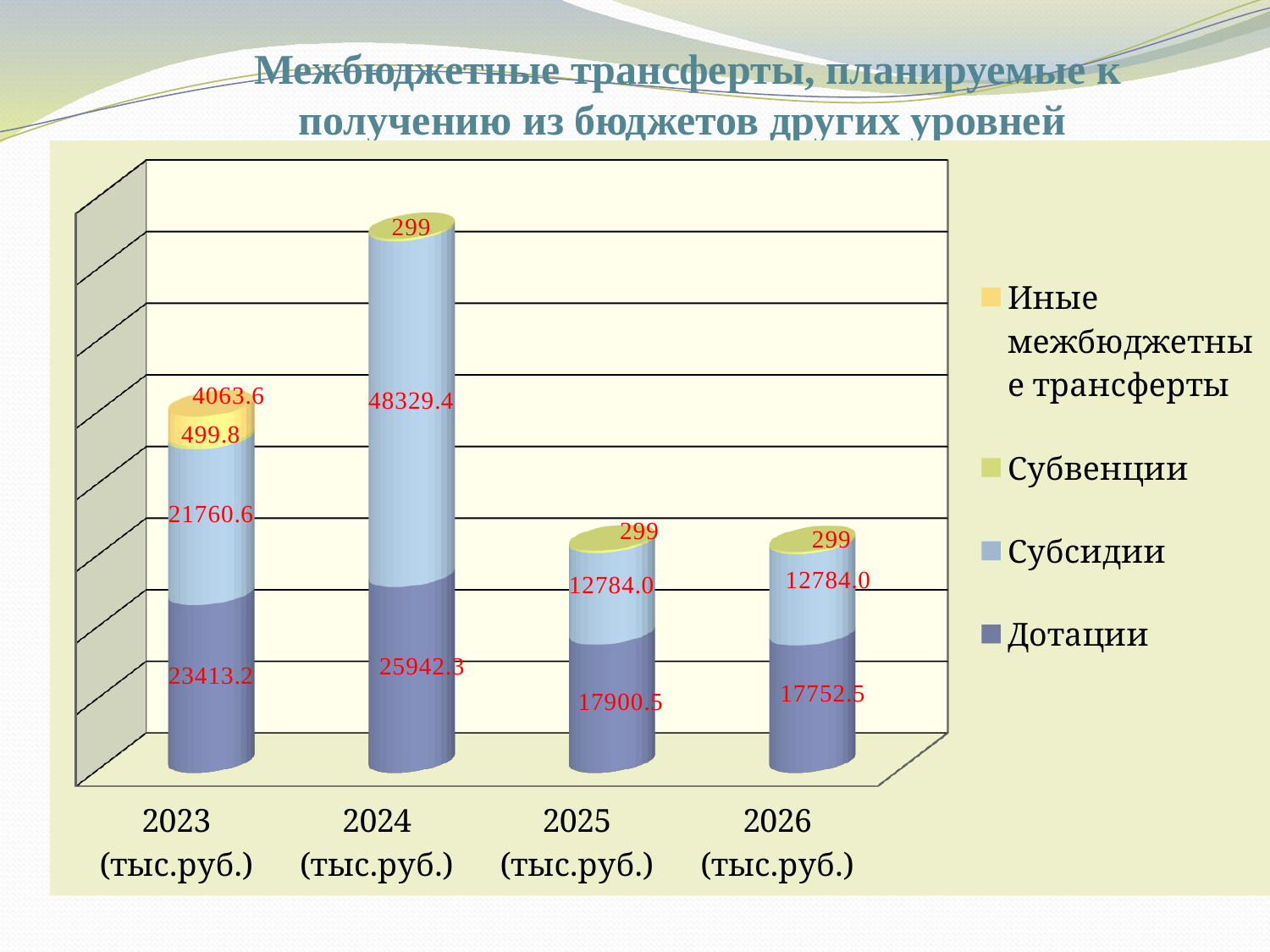
What is the value of Иные межбюджетные трансферты for 2023? 4063.6 Which is larger: Дотации for 2023 or Дотации for 2024? Дотации for 2024 Which year has the lowest value for Дотации? 2026 What kind of chart is shown on the slide? Stacked bar chart What is the total of the stacked bar for 2025? 30983.5 What is the difference between the Субсидии values for 2024 and 2023? 26568.8 What is the value of Субвенции for 2025? 299 How many years are shown on the x axis? 4 What is the value of Дотации for 2024? 25942.3 What is the value of Субсидии for 2023? 21760.6 Which year has the highest value for Субсидии? 2024 How many series does the legend list? 4